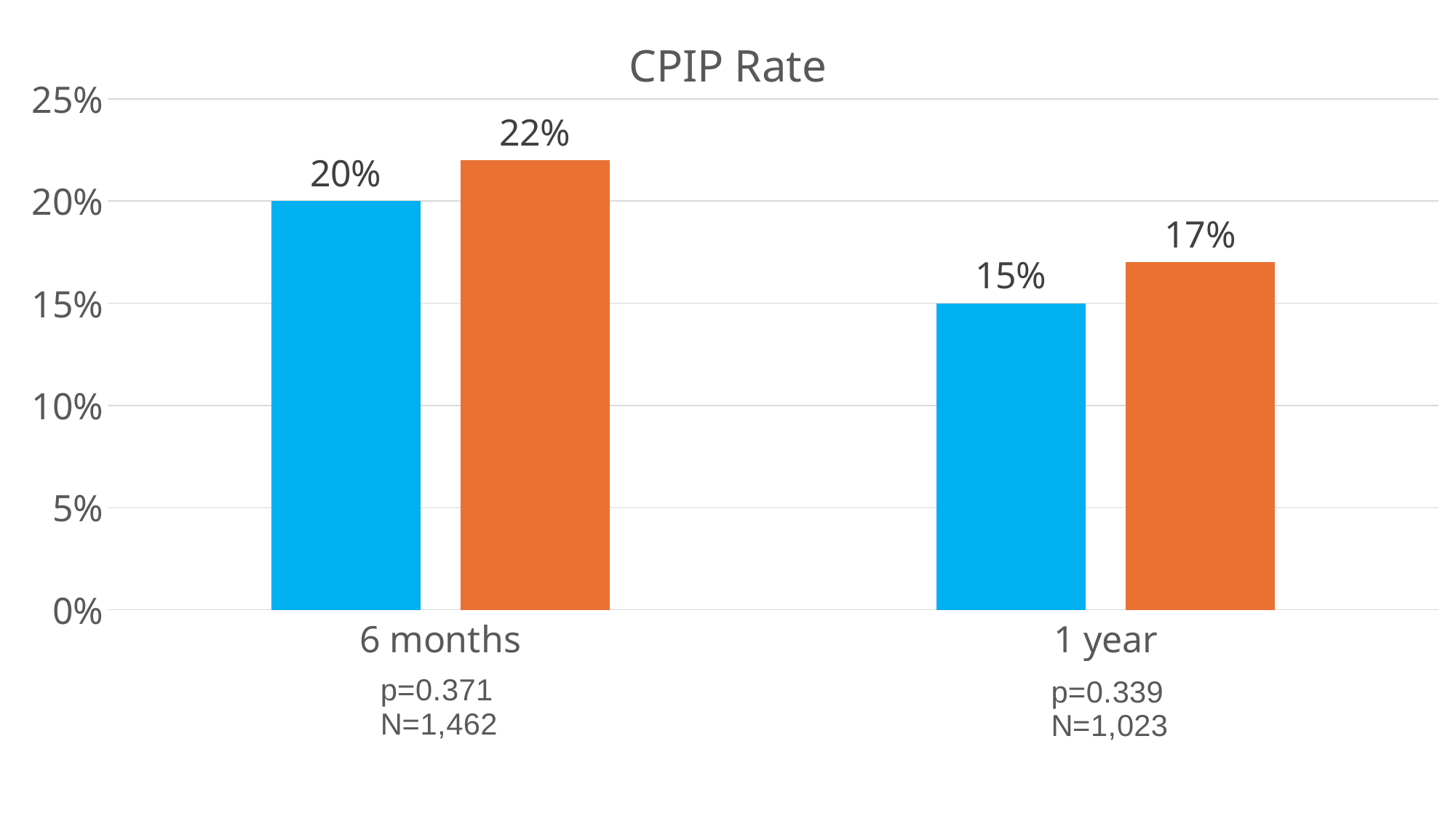
What is the value of the blue bar for 6 months? 20% Which is larger for 1 year, the blue bar or the orange bar? Orange bar What is the value of the orange bar for 6 months? 22% How many categories are shown on the x axis? 2 What is the value of the blue bar for 1 year? 15% What is the value of the orange bar for 1 year? 17% What type of chart is this? Bar chart What is the title of the chart? CPIP Rate What is the difference between the orange and blue bars for 6 months? 2% Which bar has the lowest value on the chart? Blue bar for 1 year (15%) Which bar has the highest value on the chart? Orange bar for 6 months (22%) What is the difference between the blue bar for 6 months and the blue bar for 1 year? 5%